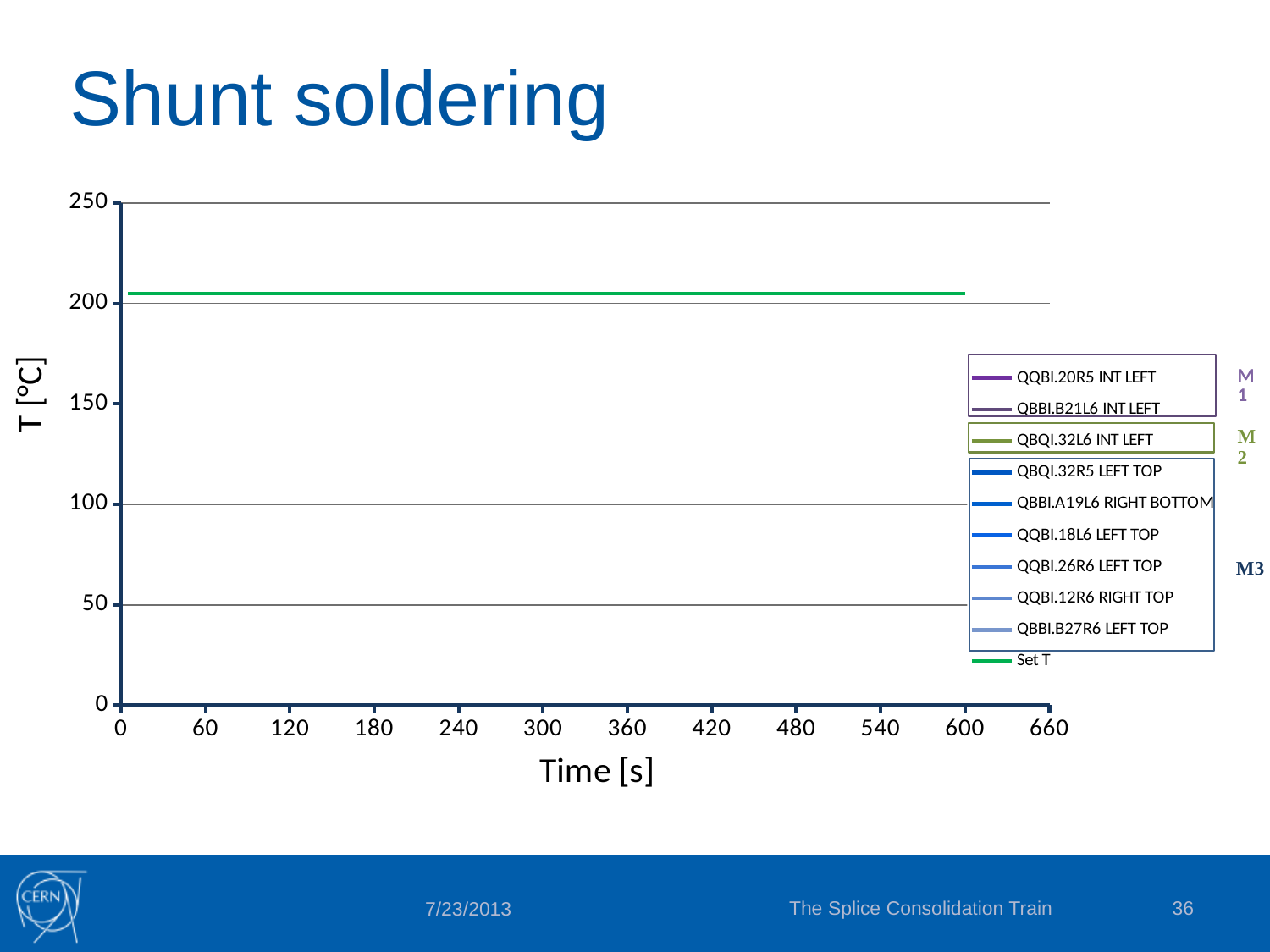
What is the last entry in the legend? Set T Is the value of the Set T line greater or less than 200? greater How many series does the legend list? 10 Is the value of the Set T line greater or less than 150? greater What is the label of the y axis? T [°C] What kind of chart is shown on the slide? line chart Is the value of the Set T line greater or less than 250? less How many tick labels are shown on the x axis? 12 Does the Set T line rise, fall or stay constant along the x axis? stays constant